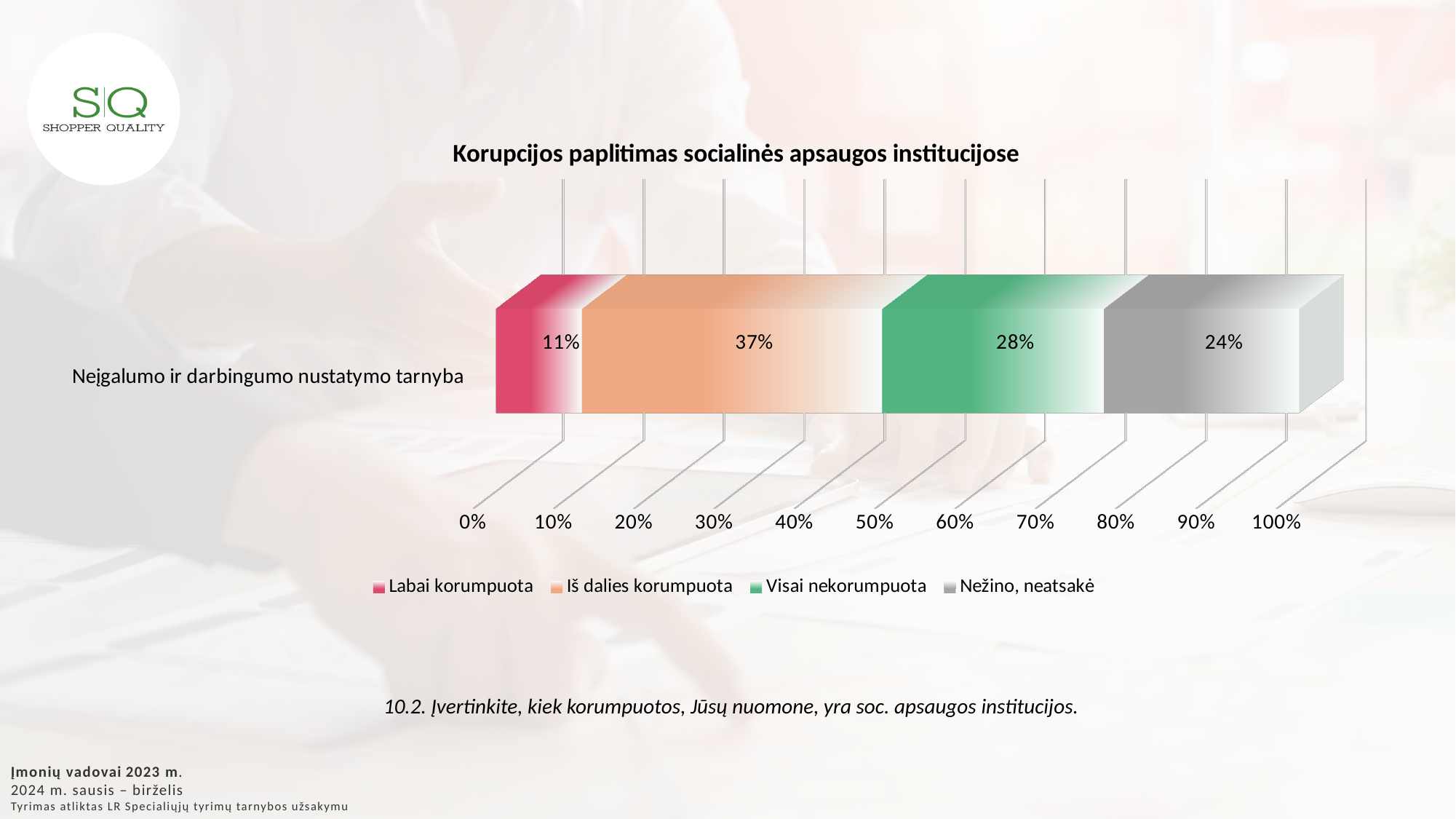
What is the title of the chart? Korupcijos paplitimas socialinės apsaugos institucijose How many series does the legend list? 4 Which series has the lowest value in the bar? Labai korumpuota What is the value for "Labai korumpuota" for Neįgalumo ir darbingumo nustatymo tarnyba? 11% What is the difference between the "Iš dalies korumpuota" and "Visai nekorumpuota" values? 9% What is the value for "Nežino, neatsakė" for Neįgalumo ir darbingumo nustatymo tarnyba? 24% What kind of chart is shown on the slide? Stacked bar chart Which series has the highest value in the bar? Iš dalies korumpuota Which is larger, the "Visai nekorumpuota" value or the "Nežino, neatsakė" value? Visai nekorumpuota What is the value for "Visai nekorumpuota" for Neįgalumo ir darbingumo nustatymo tarnyba? 28% What is the value for "Iš dalies korumpuota" for Neįgalumo ir darbingumo nustatymo tarnyba? 37% What is the total of the stacked bar for Neįgalumo ir darbingumo nustatymo tarnyba? 100%